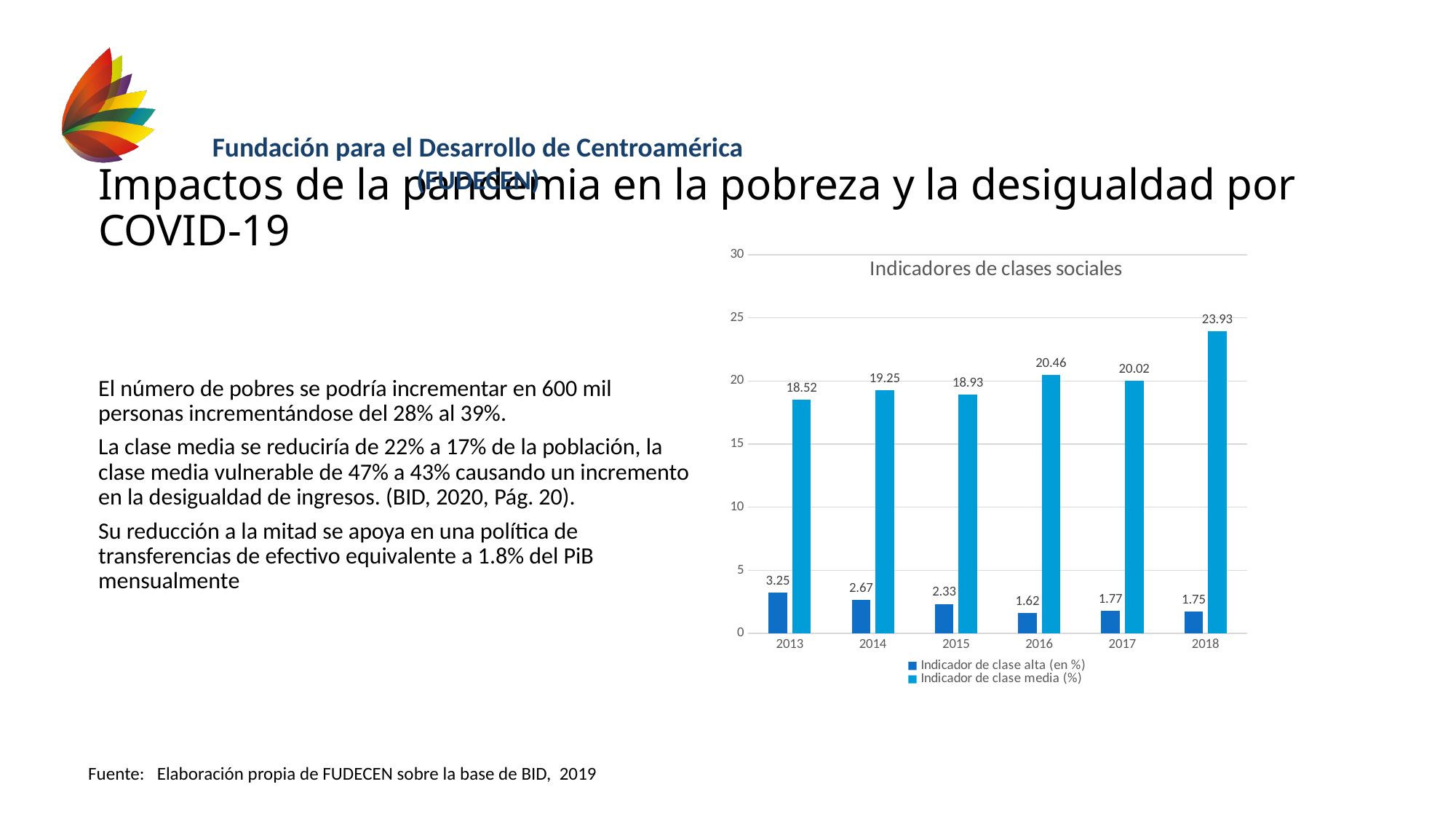
What is the difference between Indicador de clase media (%) in 2018 and in 2013? 5.41 What is the value of Indicador de clase media (%) in 2015? 18.93 Which is larger: Indicador de clase media (%) in 2016 or in 2017? 2016 What type of chart is shown on the slide? Bar chart Does Indicador de clase alta (en %) generally rise or fall from 2013 to 2016? Fall In which year is Indicador de clase alta (en %) lowest? 2016 How many years are shown on the x axis? 6 What is the value of Indicador de clase media (%) in 2018? 23.93 What is the title of the chart? Indicadores de clases sociales In which year is Indicador de clase media (%) highest? 2018 What is the value of Indicador de clase alta (en %) in 2013? 3.25 How many series does the legend list? 2